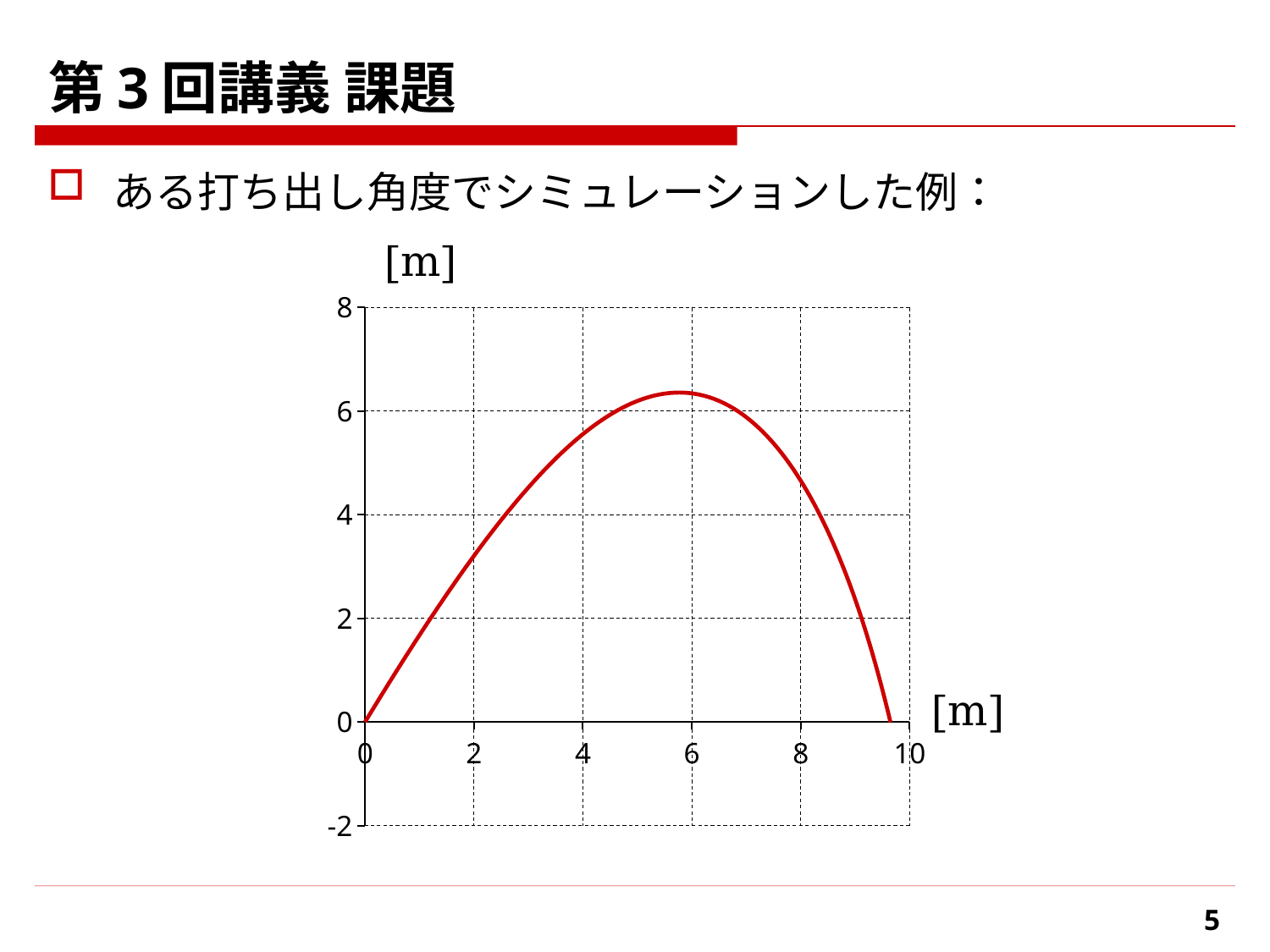
Is the value of the curve at x = 2 greater or less than 2? greater How does the curve behave as x increases from 0 to 10? rises then falls Is the maximum height reached by the curve greater or less than 8? less Is the x position where the curve returns to 0 greater or less than 8? greater What kind of chart is shown on the slide? line chart What is the value of the curve at x = 0? 0 What colour is the plotted curve? red What unit is shown on both axes of the chart? [m] Is the value of the curve at x = 4 larger or smaller than its value at x = 8? larger